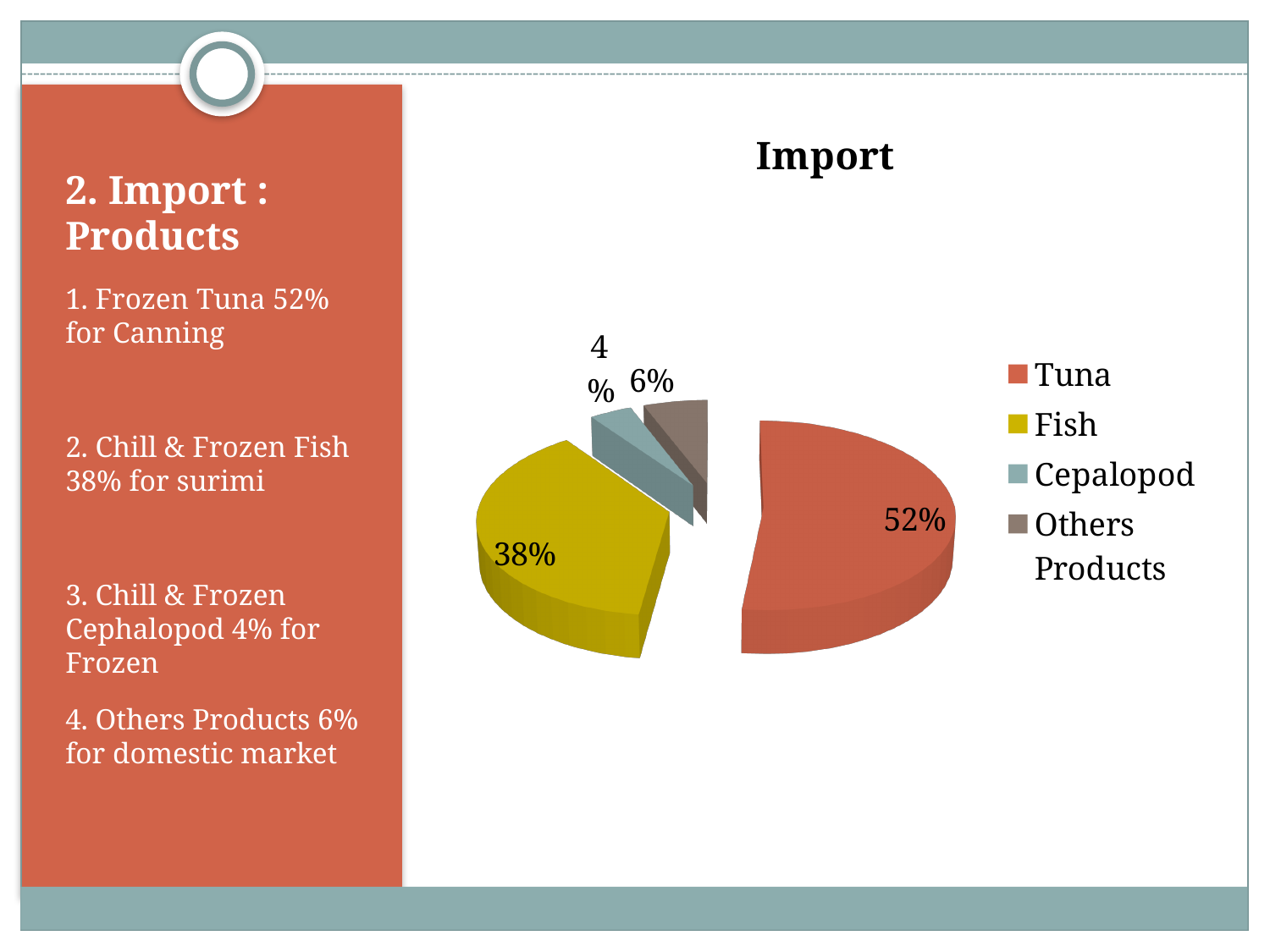
Which is larger, the share for Others Products or the share for Cepalopod? Others Products What share of the pie does Cepalopod have? 4% What colour is the Fish slice in the pie chart? yellow What share of the pie does Others Products have? 6% Which category has the smallest slice of the pie? Cepalopod What share of the pie does Fish have? 38% What is the title of the chart? Import Which category has the largest slice of the pie? Tuna How many categories does the pie chart show? 4 What kind of chart is shown on the slide? pie chart What is the difference between the Tuna share and the Fish share? 14%